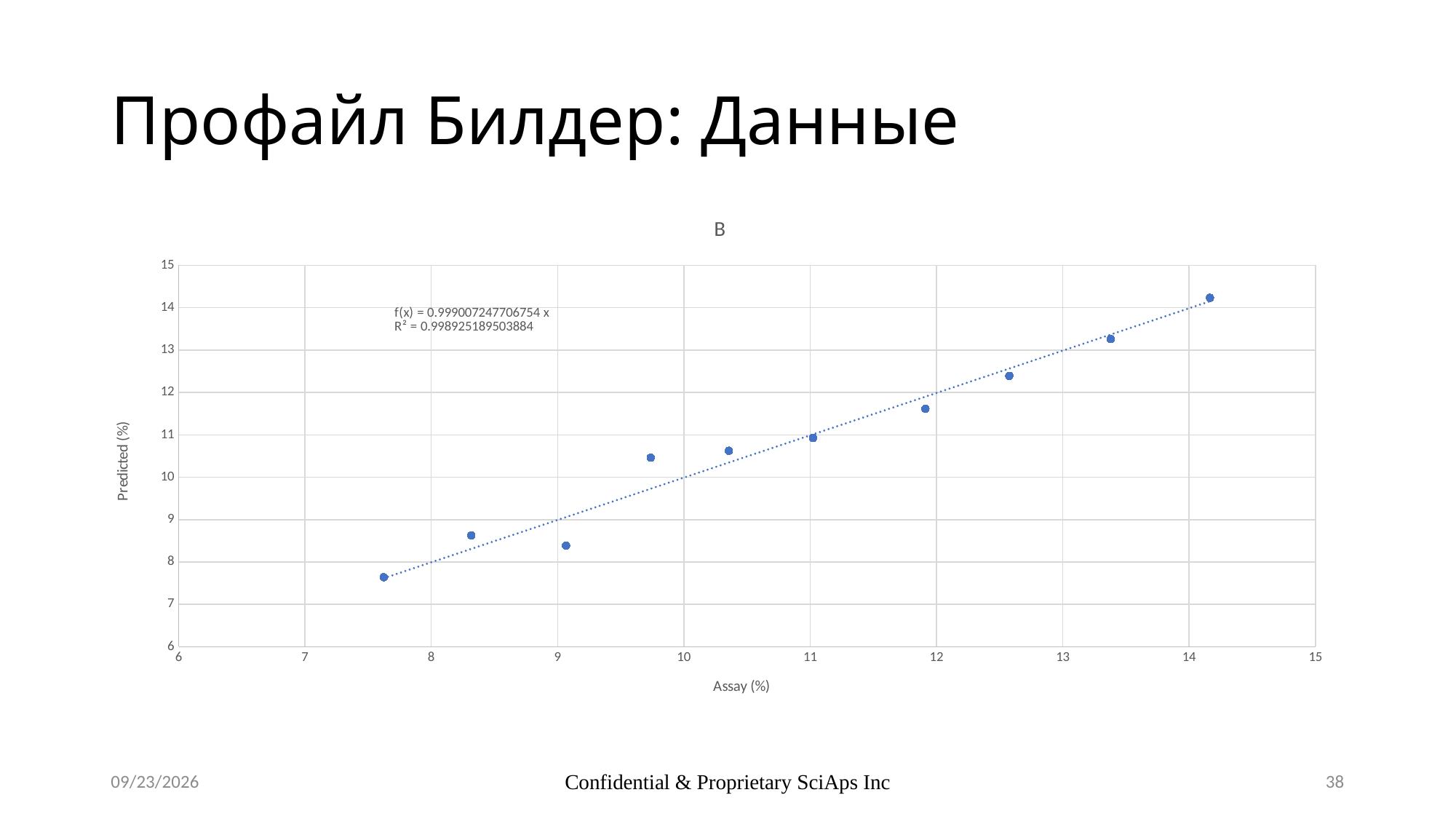
What is the R² value shown for the trendline? 0.998925189503884 What is the title of the chart? B Is the Predicted (%) value of the rightmost data point greater or less than 13? greater Do the Predicted (%) values rise or fall as Assay (%) increases? Rise Is the Predicted (%) value of the data point with the lowest Assay (%) greater or less than 7? greater What is the trendline equation shown on the chart? f(x) = 0.999007247706754 x What is the label of the x axis? Assay (%) What kind of chart is shown on the slide? Scatter chart How many data points are plotted in the chart? 10 What is the minimum value shown on the x axis? 6 Is the Predicted (%) value of the leftmost data point greater or less than 8? less What is the maximum value shown on the y axis? 15